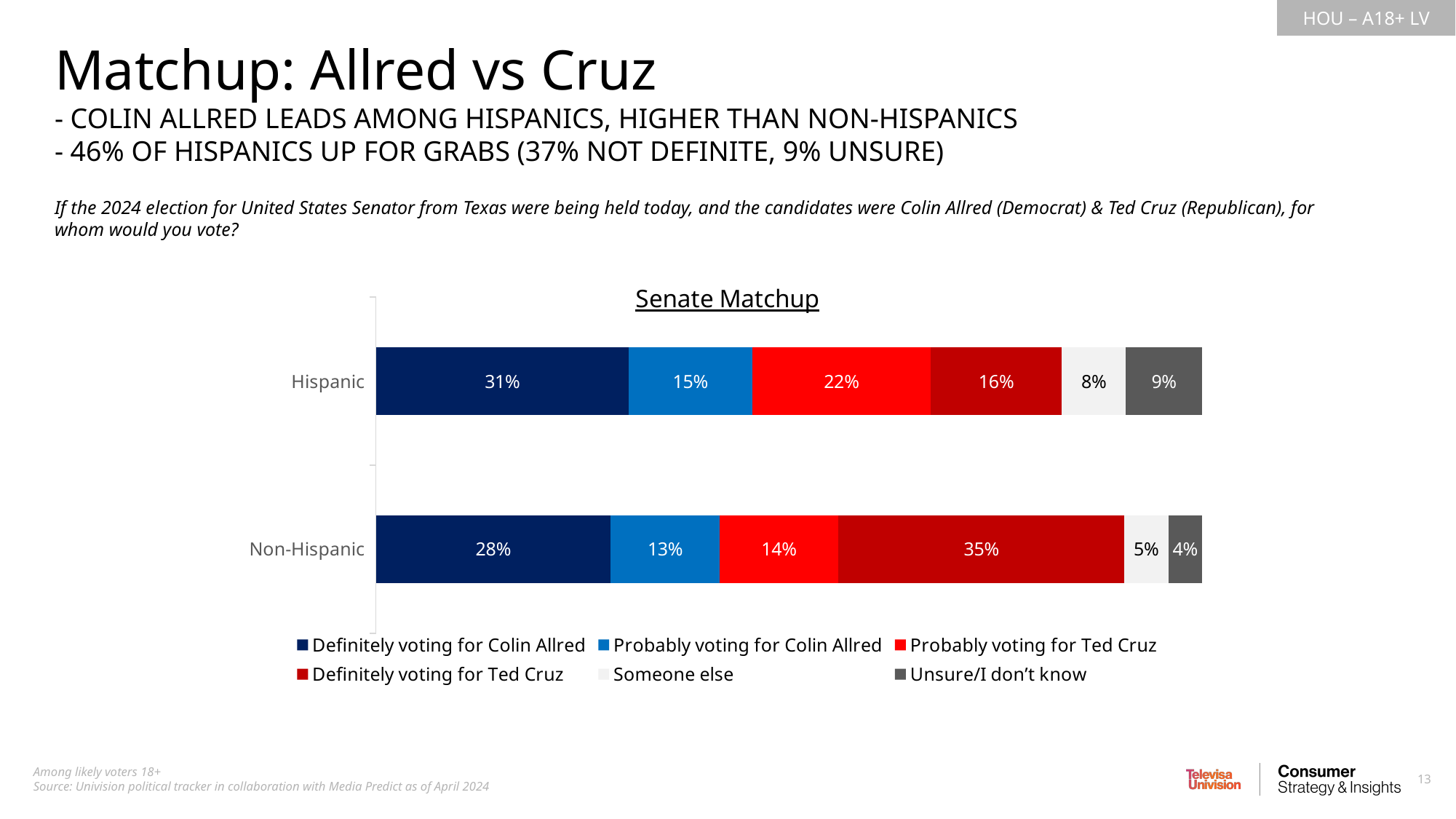
How many categories are shown on the chart? 2 What percentage of Hispanic respondents are unsure/don't know? 9% How many series does the legend list? 6 Which category has the higher share definitely voting for Ted Cruz, Hispanic or Non-Hispanic? Non-Hispanic What kind of chart is shown? Stacked bar chart What is the title of the chart? Senate Matchup What percentage of Non-Hispanic likely voters are definitely voting for Ted Cruz? 35% What is the difference between the Hispanic and Non-Hispanic shares probably voting for Ted Cruz? 8% What percentage of Hispanic likely voters are definitely voting for Colin Allred? 31% What percentage of Non-Hispanic respondents chose someone else? 5% What is the combined share of Hispanic respondents definitely or probably voting for Colin Allred? 46% What is the combined share of Non-Hispanic respondents definitely or probably voting for Ted Cruz? 49%